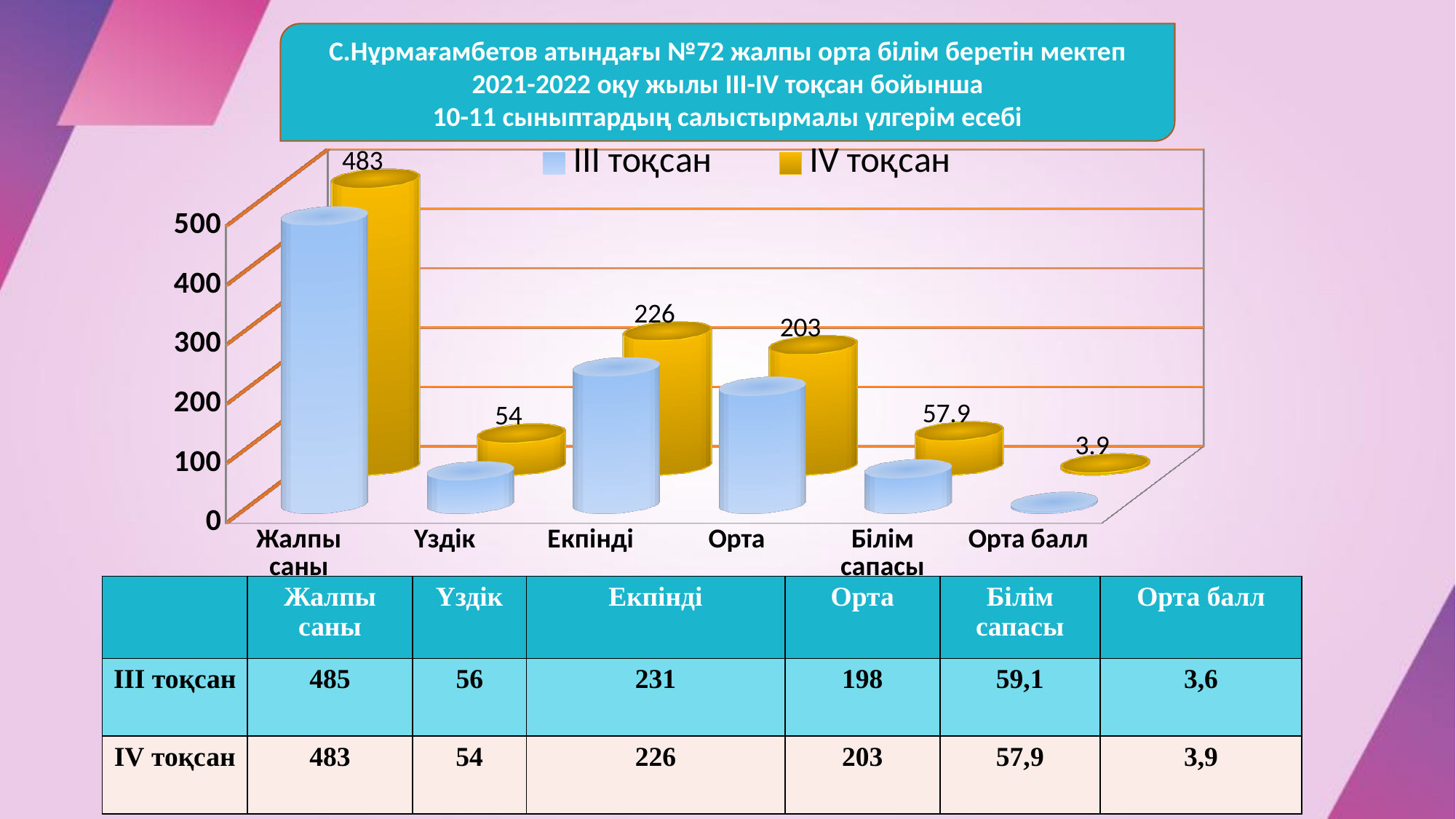
What is the value for Орта in the IV тоқсан series? 203 What is the value for Білім сапасы in the IV тоқсан series? 57.9 In the IV тоқсан series, which is larger: Үздік or Білім сапасы? Білім сапасы Which category has the lowest value in the IV тоқсан series? Орта балл What is the value for Орта балл in the IV тоқсан series? 3.9 Is the value for Жалпы саны in the III тоқсан series greater or less than 400? greater How many categories are shown on the x axis of the chart? 6 What is the difference between the IV тоқсан values for Екпінді and Орта? 23 Which category has the highest value in the IV тоқсан series? Жалпы саны What is the value for Екпінді in the IV тоқсан series? 226 How many series does the chart legend list? 2 What is the value for Жалпы саны in the IV тоқсан series? 483